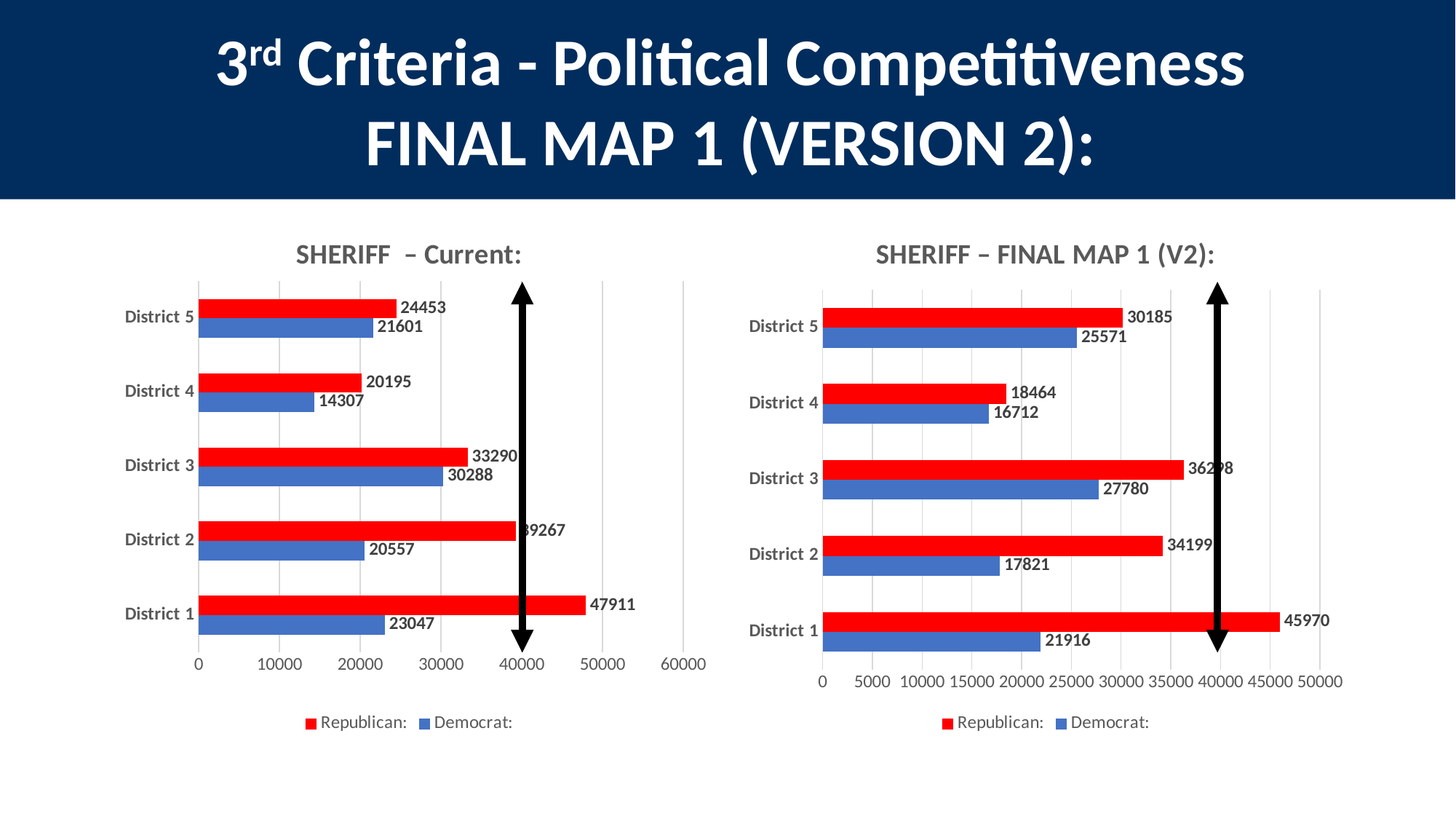
In the SHERIFF – Current chart, what is the Republican value for District 1? 47911 In the SHERIFF – FINAL MAP 1 (V2) chart, is the Democrat value for District 1 larger or smaller than the Democrat value for District 2? larger How many districts are shown in the SHERIFF – FINAL MAP 1 (V2) chart? 5 How many series does the legend of the SHERIFF – Current chart list? 2 In the SHERIFF – FINAL MAP 1 (V2) chart, what is the Democrat value for District 5? 25571 In the SHERIFF – FINAL MAP 1 (V2) chart, what is the difference between the Republican and Democrat values for District 4? 1752 In the SHERIFF – Current chart, is the Republican value for District 2 greater or less than 30000? greater In the SHERIFF – FINAL MAP 1 (V2) chart, which district has the highest Republican value? District 1 In the SHERIFF – Current chart, what is the difference between the Republican and Democrat values for District 5? 2852 In the SHERIFF – FINAL MAP 1 (V2) chart, what is the Republican value for District 2? 34199 In the SHERIFF – Current chart, what is the Democrat value for District 3? 30288 In the SHERIFF – Current chart, which district has the lowest Democrat value? District 4